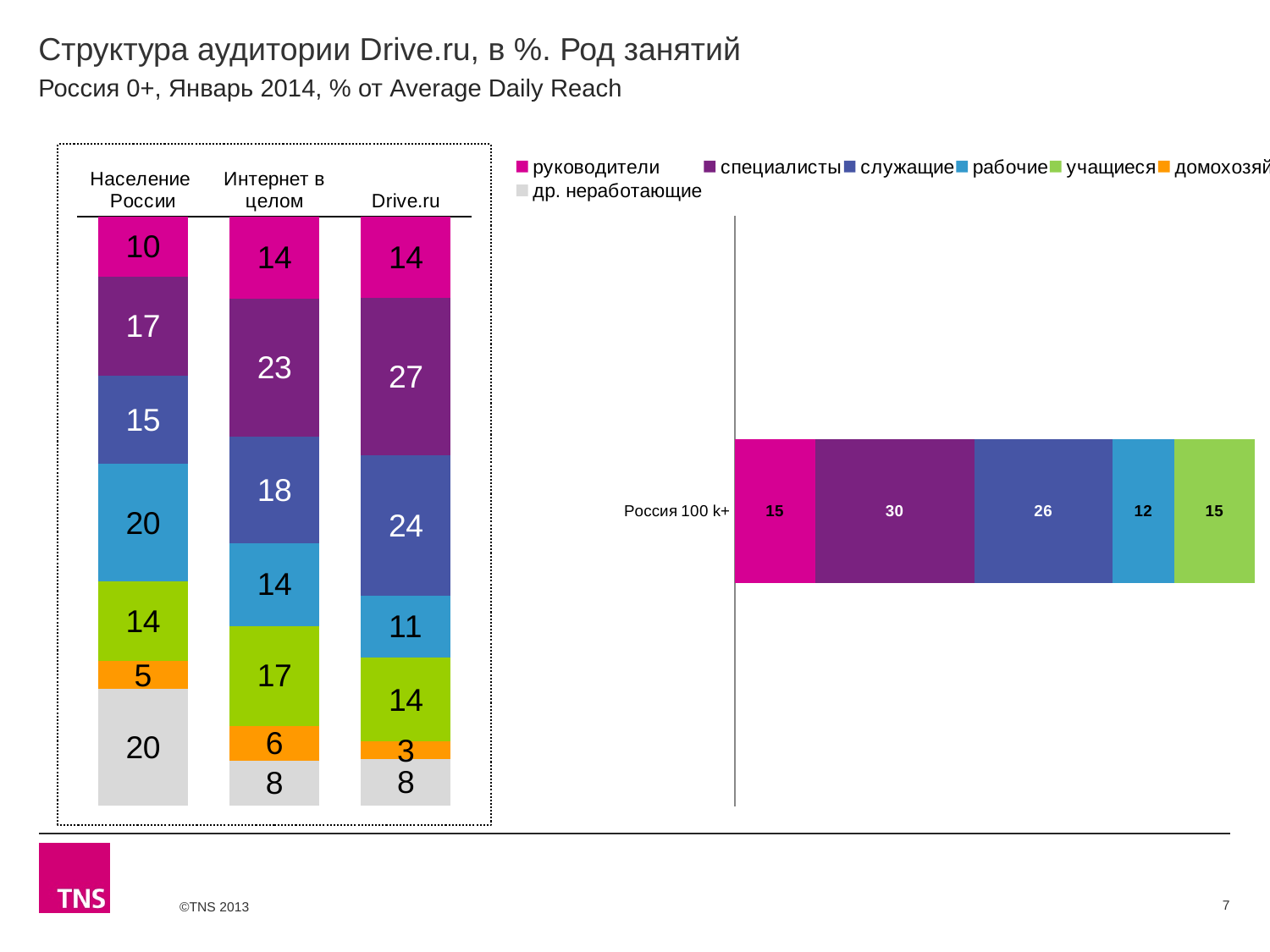
What kind of chart is the Россия 100 k+ chart on the right? Stacked bar chart In the Россия 100 k+ chart on the right, what is the value for специалисты? 30 How many occupation groups does the legend on the right list? 7 In the left stacked bar chart, which occupation group has the largest segment in the Drive.ru column? специалисты In the left stacked bar chart, what is the difference between the специалисты values for Drive.ru and Население России? 10 In the Россия 100 k+ chart on the right, what is the value for служащие? 26 How many columns (audience groups) are shown in the left stacked bar chart? 3 In the left stacked bar chart, what is the value for рабочие (light blue segment) in the Население России column? 20 In the left stacked bar chart, what is the value for учащиеся (green segment) in the Интернет в целом column? 17 In the left stacked bar chart, which occupation group has the smallest segment in the Drive.ru column? домохозяйки In the left stacked bar chart, which column has the larger служащие value: Drive.ru or Интернет в целом? Drive.ru In the left stacked bar chart, what is the value for специалисты in the Drive.ru column? 27